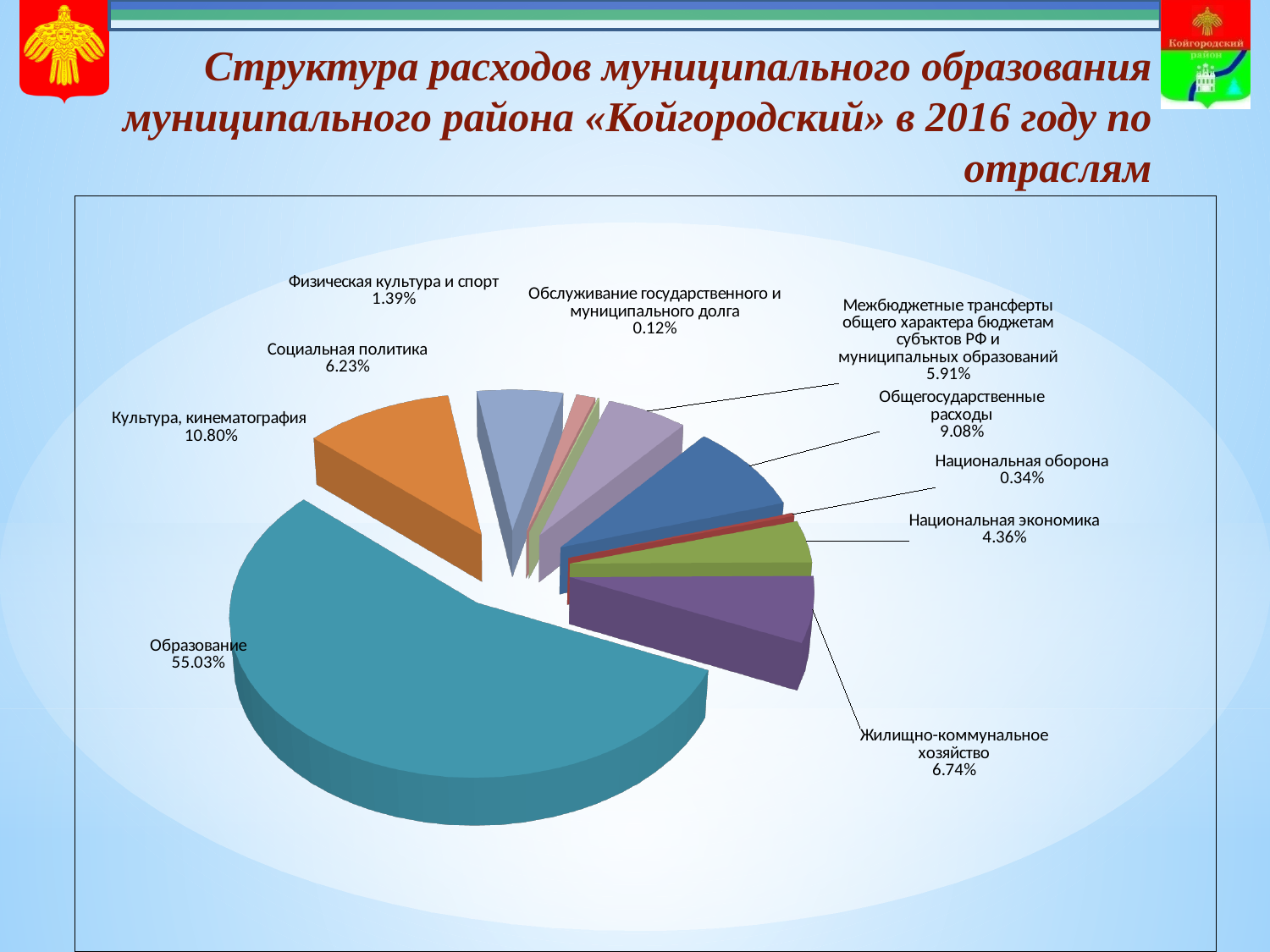
Which category has the largest share of the pie? Образование What is the difference between the shares of Социальная политика and Национальная экономика? 1.87% What year does the chart title say the expenditure structure refers to? 2016 What is the value for Культура, кинематография? 10.80% What is the value for Межбюджетные трансферты общего характера бюджетам субъктов РФ и муниципальных образований? 5.91% How many categories are shown in the pie chart? 10 What kind of chart is shown on the slide? Pie chart What share of expenditures goes to Образование? 55.03% What is the value for Общегосударственные расходы? 9.08% Which category has the smallest share of the pie? Обслуживание государственного и муниципального долга What percentage is shown for Жилищно-коммунальное хозяйство? 6.74% Which is larger: Национальная оборона or Физическая культура и спорт? Физическая культура и спорт